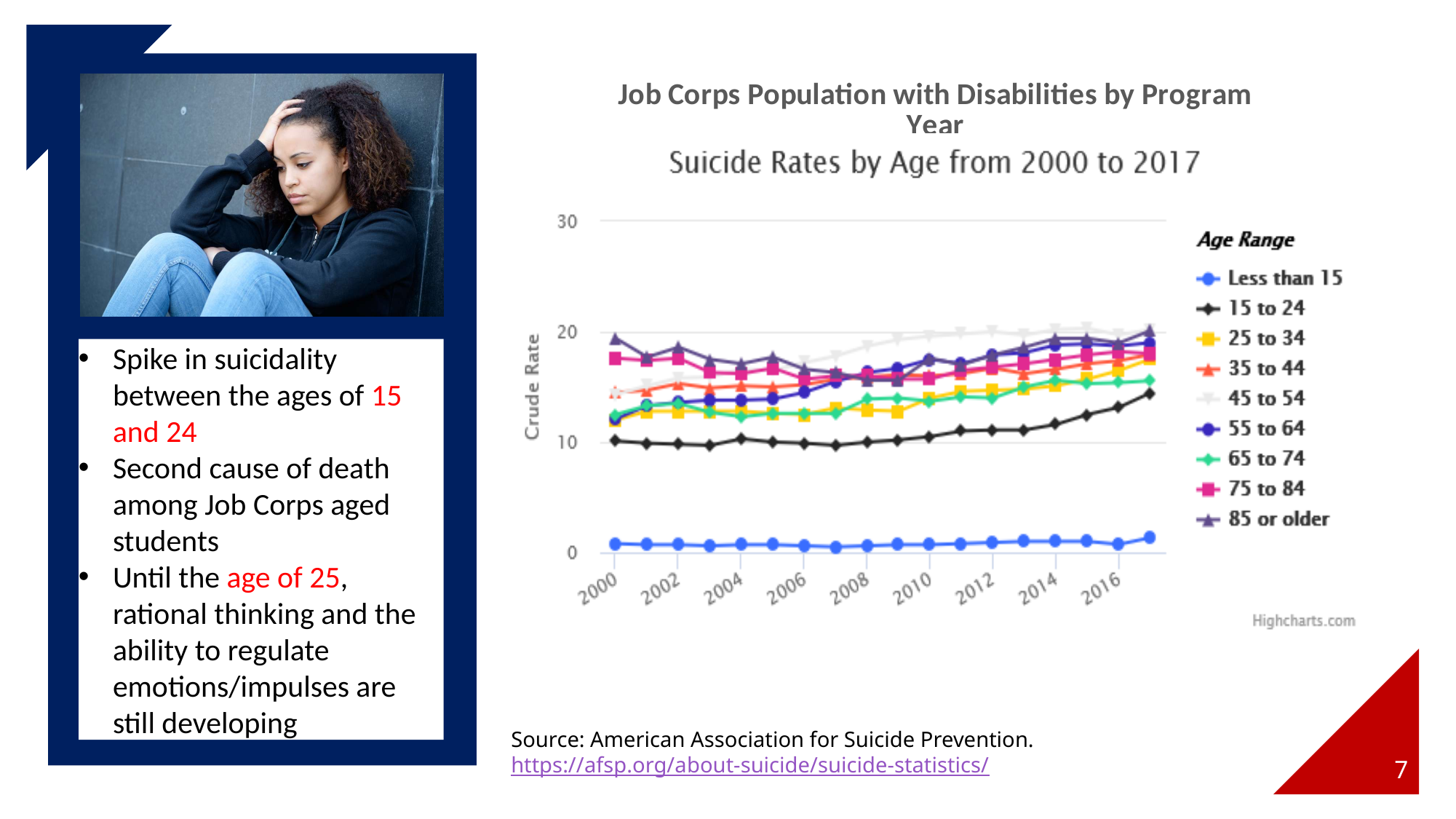
What is the label on the vertical axis of the chart? Crude Rate Which age range has the lowest crude rate across all years in the chart? Less than 15 Is the crude rate for the Less than 15 age range in 2016 greater or less than 10? less In 2000, which has the higher crude rate: the 15 to 24 age range or the 75 to 84 age range? 75 to 84 How many age ranges does the legend of the chart list? 9 What is the title of the legend in the chart? Age Range What kind of chart is shown on the slide? line chart Is the crude rate for the 15 to 24 age range in 2017 greater or less than 20? less How many years are plotted along the x axis of the chart, from 2000 to 2017? 18 Is the crude rate for the 15 to 24 age range in 2017 greater or less than 10? greater Does the crude rate for the 15 to 24 age range rise or fall between 2010 and 2017? rise